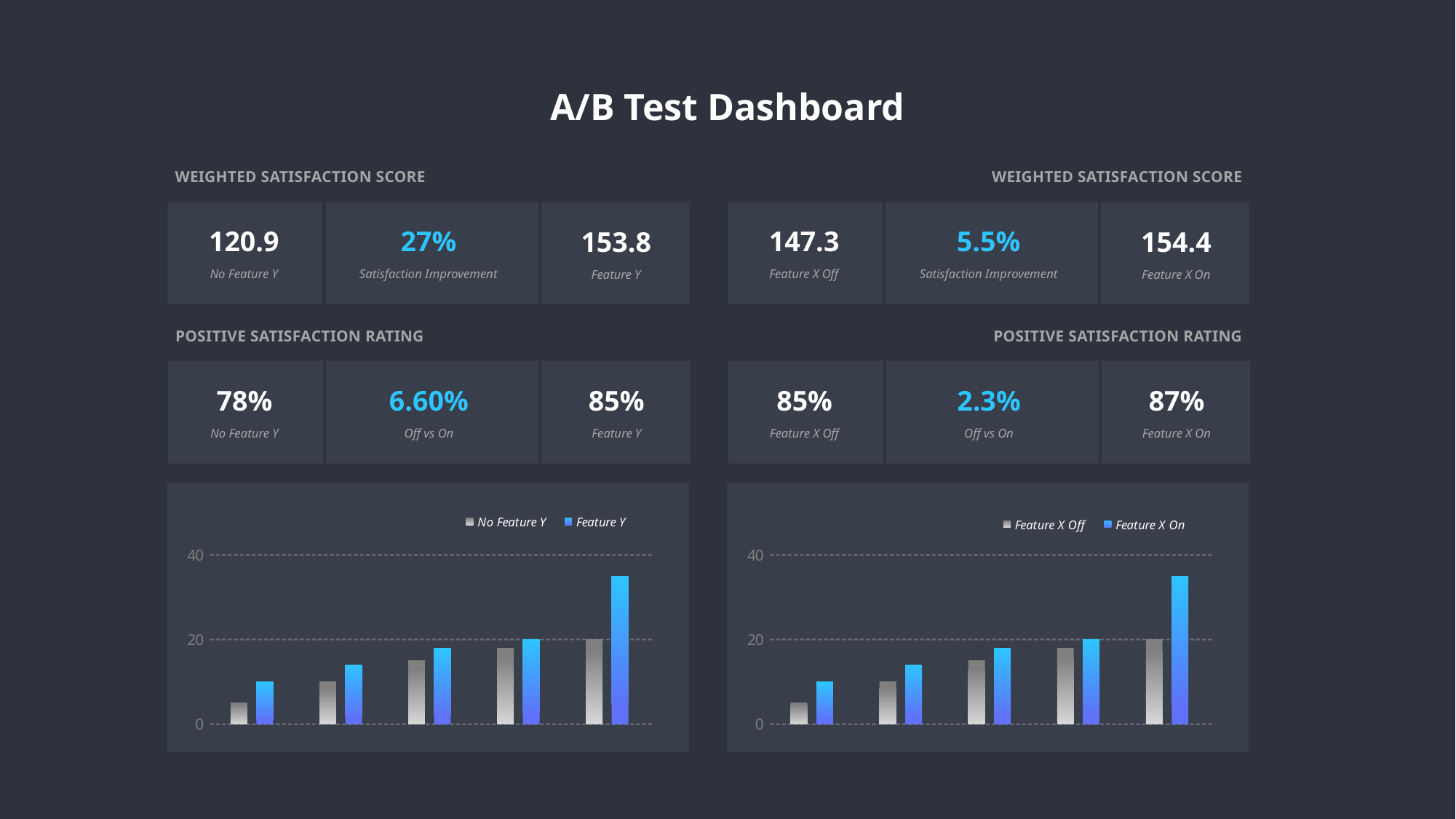
How many groups of bars are plotted in the left chart? 5 In the left chart, which series has the taller bar in the rightmost group, No Feature Y or Feature Y? Feature Y How many series does the legend of the left chart list? 2 What kind of chart is the left chart (legend: No Feature Y, Feature Y)? bar chart How many series does the legend of the right chart list? 2 In the right chart, is the first Feature X Off bar greater or less than 20? less What kind of chart is the right chart (legend: Feature X Off, Feature X On)? bar chart In the right chart, do the Feature X On bars rise or fall from left to right? rise In the right chart, which series has the taller bar in the first group, Feature X Off or Feature X On? Feature X On In the left chart, is the tallest Feature Y bar greater or less than 20? greater How many groups of bars are plotted in the right chart? 5 What are the two legend entries of the right chart? Feature X Off, Feature X On